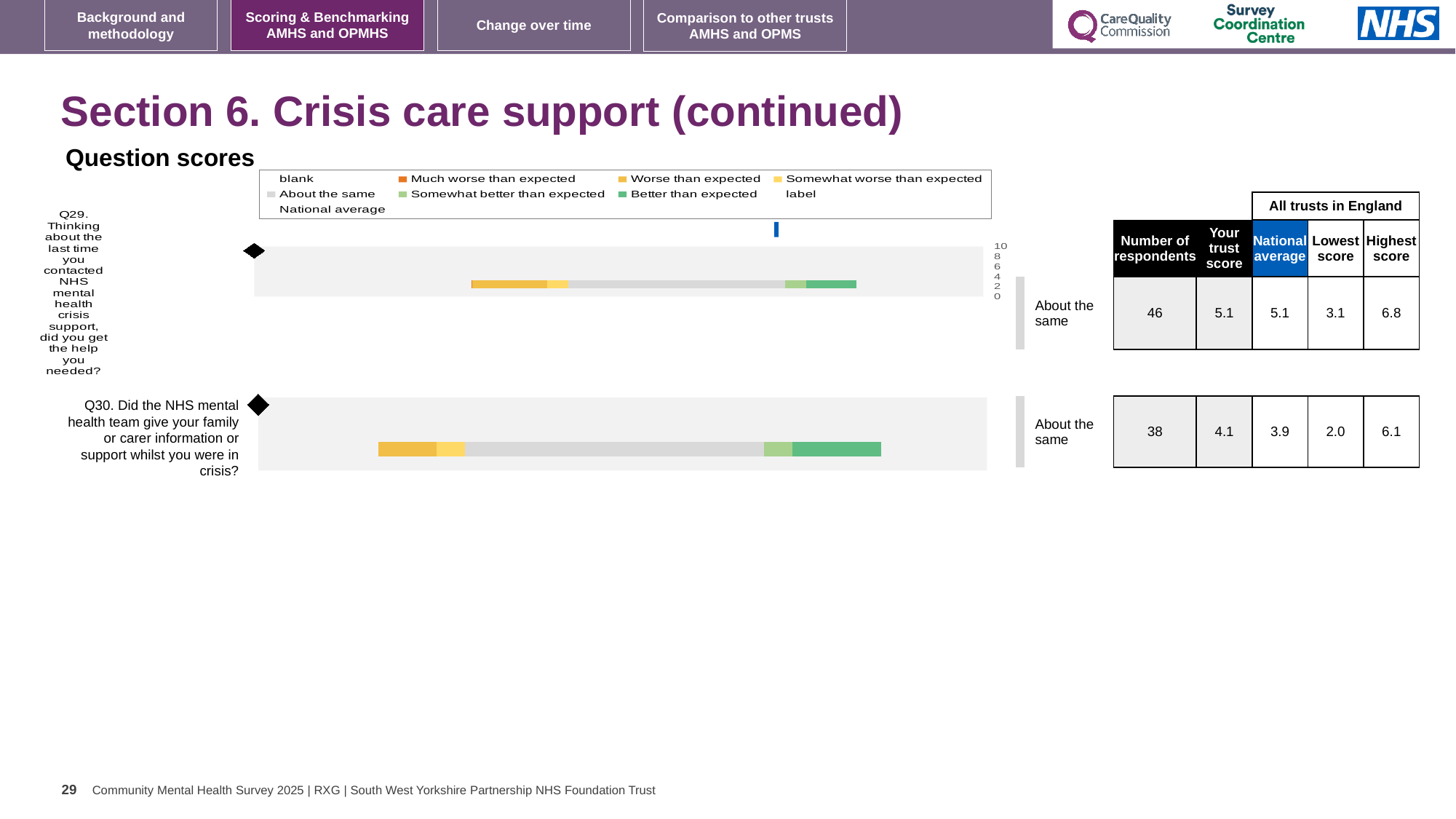
What is the trust score for Q30 (information or support for family or carer) shown on the slide? 4.1 What is the national average score for Q30 shown on the slide? 3.9 What colour represents 'Better than expected' in the chart legend? green How many respondents answered Q29? 46 By how much does the trust score for Q30 exceed the national average for Q30? 0.2 Which question has the higher trust score, Q29 or Q30? Q29 How many entries does the legend of the question scores chart list? 9 What is the highest score across all trusts in England for Q29? 6.8 How many questions (bars) are plotted in the question scores chart? 2 What is the trust score for Q29 (did you get the help you needed?) shown on the slide? 5.1 What benchmark category is shown for Q30 next to the chart? About the same What kind of chart is used to show the question scores on this slide? bar chart